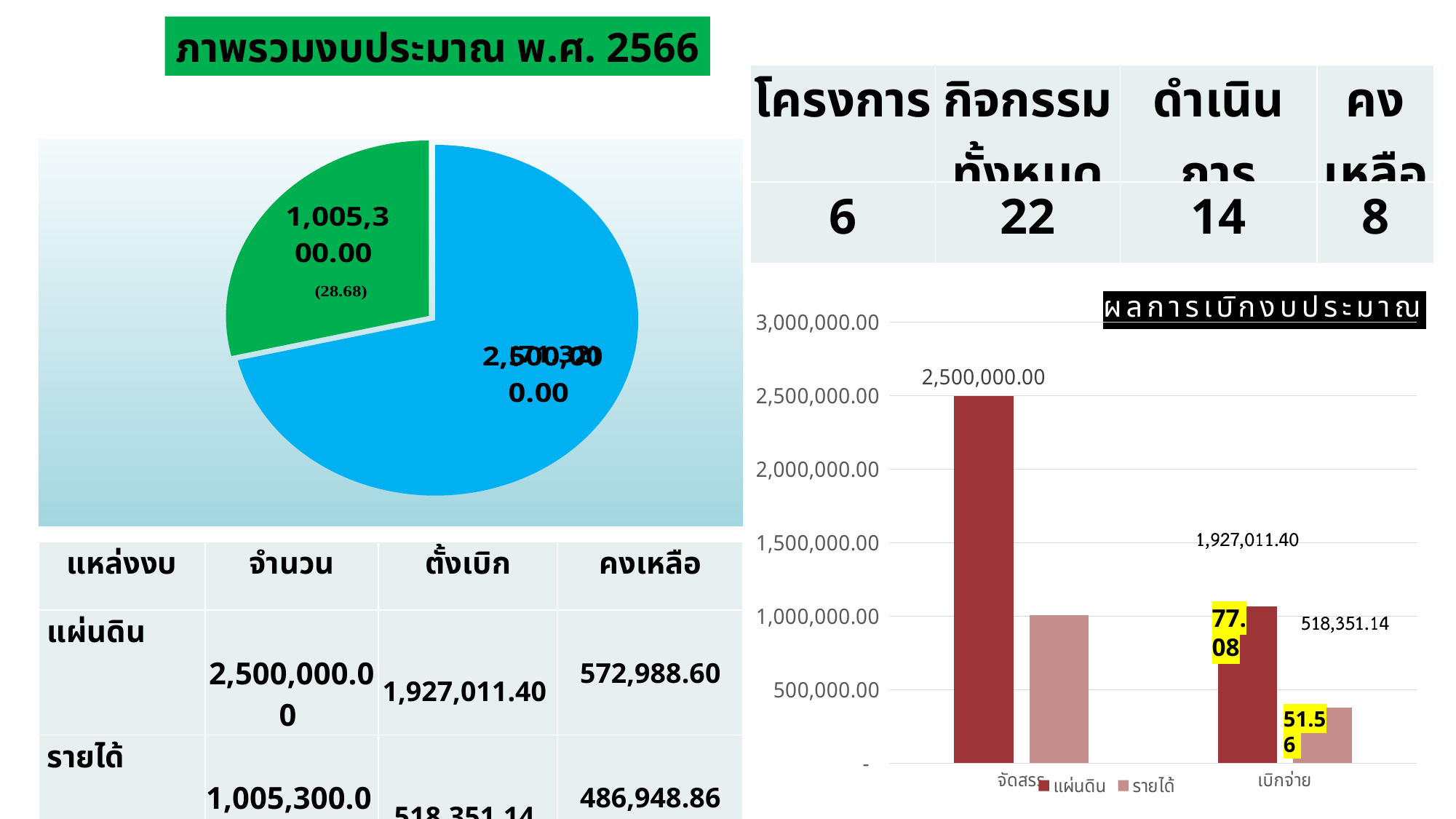
In the pie chart on the left, what value is printed on the green slice? 1,005,300.00 What kind of chart is the chart on the left of the slide? pie chart In the chart titled ผลการเบิกงบประมาณ, does the แผ่นดิน series rise or fall from จัดสรร to เบิกจ่าย? fall In the pie chart on the left, what percentage share is printed on the green slice? 28.68 In the pie chart on the left, which slice is larger, the blue one or the green one? blue How many series does the legend of the chart titled ผลการเบิกงบประมาณ list? 2 In the chart titled ผลการเบิกงบประมาณ, which bar is the tallest? แผ่นดิน for จัดสรร In the chart titled ผลการเบิกงบประมาณ, is the value of รายได้ for จัดสรร greater or less than 1,500,000.00? less In the chart titled ผลการเบิกงบประมาณ, what is the value of แผ่นดิน for จัดสรร? 2,500,000.00 How many slices does the pie chart on the left have? 2 What kind of chart is the chart titled ผลการเบิกงบประมาณ? bar chart In the chart titled ผลการเบิกงบประมาณ, is the value of รายได้ for เบิกจ่าย greater or less than 500,000.00? less